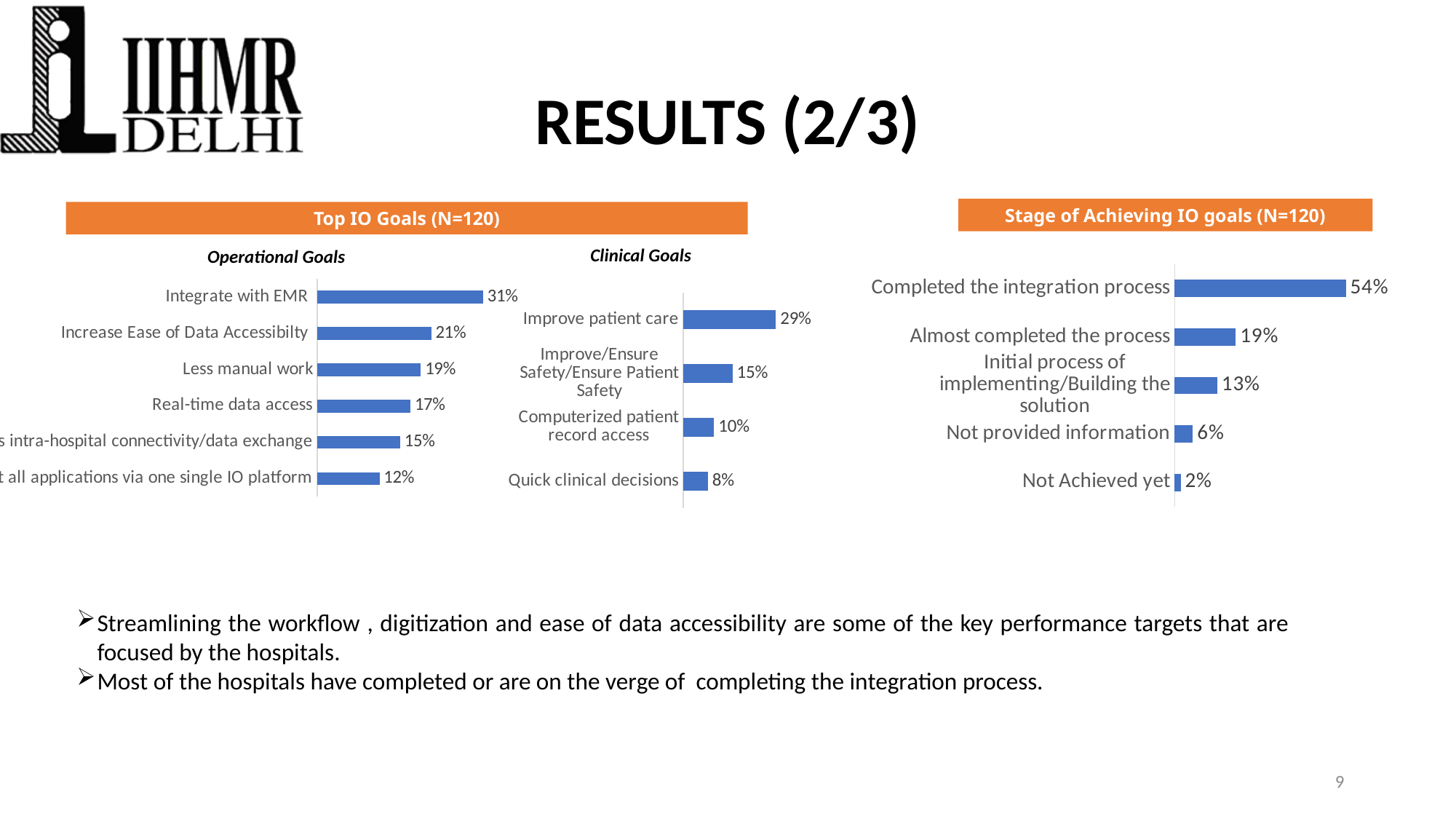
In the Stage of Achieving IO goals chart, what percentage is shown for Not Achieved yet? 2% In the Clinical Goals chart, how many categories are plotted? 4 In the Operational Goals chart, what percentage is shown for Integrate with EMR? 31% In the Operational Goals chart, what percentage is shown for Less manual work? 19% What type of chart is the Stage of Achieving IO goals chart? Bar chart In the Clinical Goals chart, what percentage is shown for Improve patient care? 29% In the Stage of Achieving IO goals chart, what is the difference between Almost completed the process and Not provided information? 13% In the Clinical Goals chart, which is larger: Computerized patient record access or Quick clinical decisions? Computerized patient record access In the Stage of Achieving IO goals chart, what percentage is shown for Completed the integration process? 54% In the Clinical Goals chart, which category has the lowest value? Quick clinical decisions In the Operational Goals chart, which category has the highest value? Integrate with EMR In the Operational Goals chart, what is the difference between Integrate with EMR and Increase Ease of Data Accessibilty? 10%